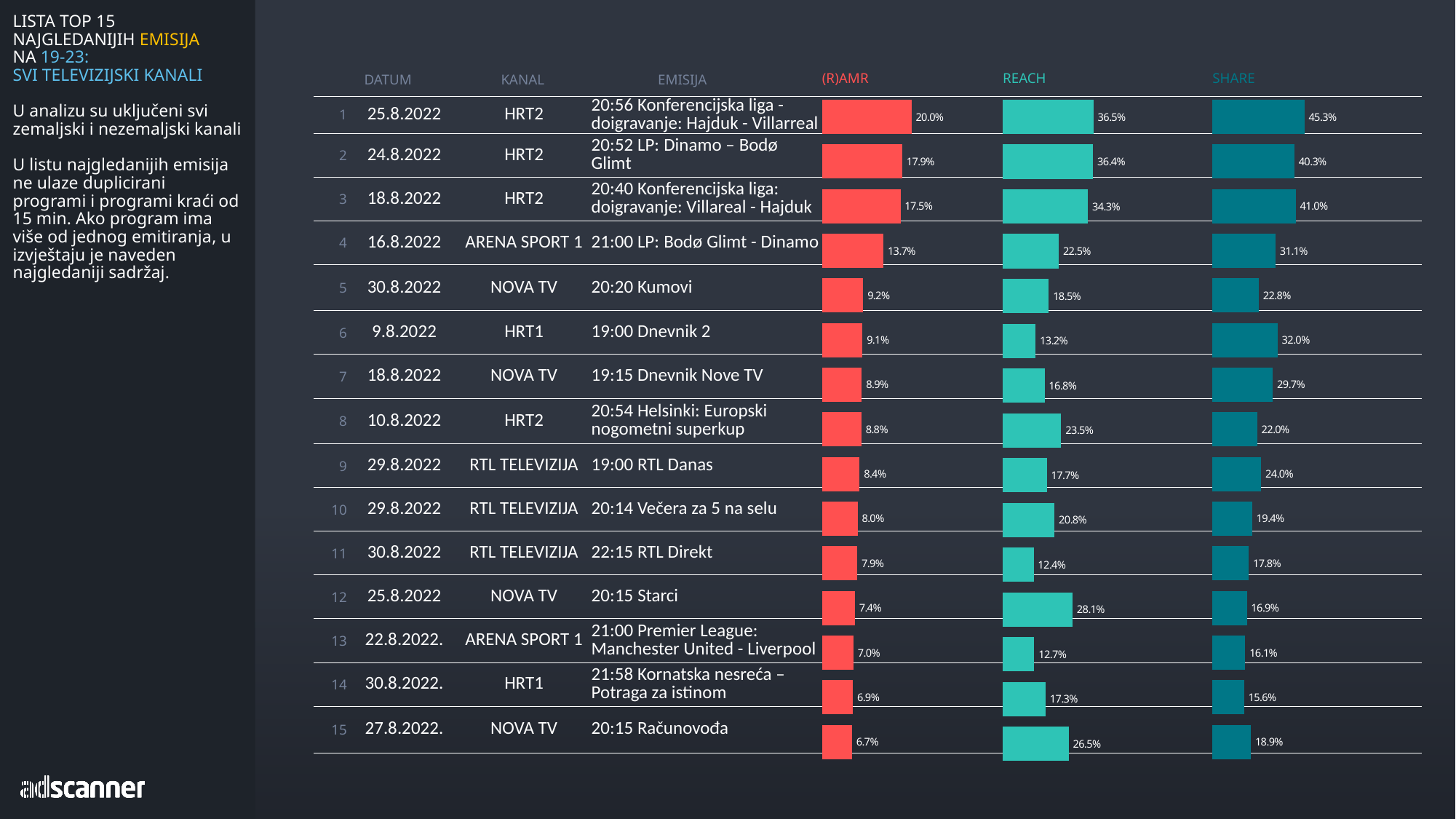
In the REACH chart, which is larger: 20:15 Računovođa or 20:54 Helsinki: Europski nogometni superkup? 20:15 Računovođa In the SHARE chart, what is the value for 19:00 Dnevnik 2? 32.0% How many programmes (rows) are plotted in each bar chart? 15 In the SHARE chart, what is the difference between the top-ranked programme (45.3%) and 20:14 Večera za 5 na selu? 25.9% In the SHARE chart, which programme has the lowest value? 21:58 Kornatska nesreća – Potraga za istinom Do the (R)AMR values rise or fall going down the list from rank 1 to rank 15? Fall In the (R)AMR chart, what is the value for 20:20 Kumovi? 9.2% In the REACH chart, which programme has the lowest value? 22:15 RTL Direkt In the (R)AMR chart, what is the difference between 20:52 LP: Dinamo – Bodø Glimt and 21:00 LP: Bodø Glimt - Dinamo? 4.2% In the REACH chart, what is the value for 20:15 Starci? 28.1% What kind of chart is used for the (R)AMR, REACH and SHARE columns? Bar chart In the (R)AMR chart, which programme has the highest value? 20:56 Konferencijska liga - doigravanje: Hajduk - Villarreal